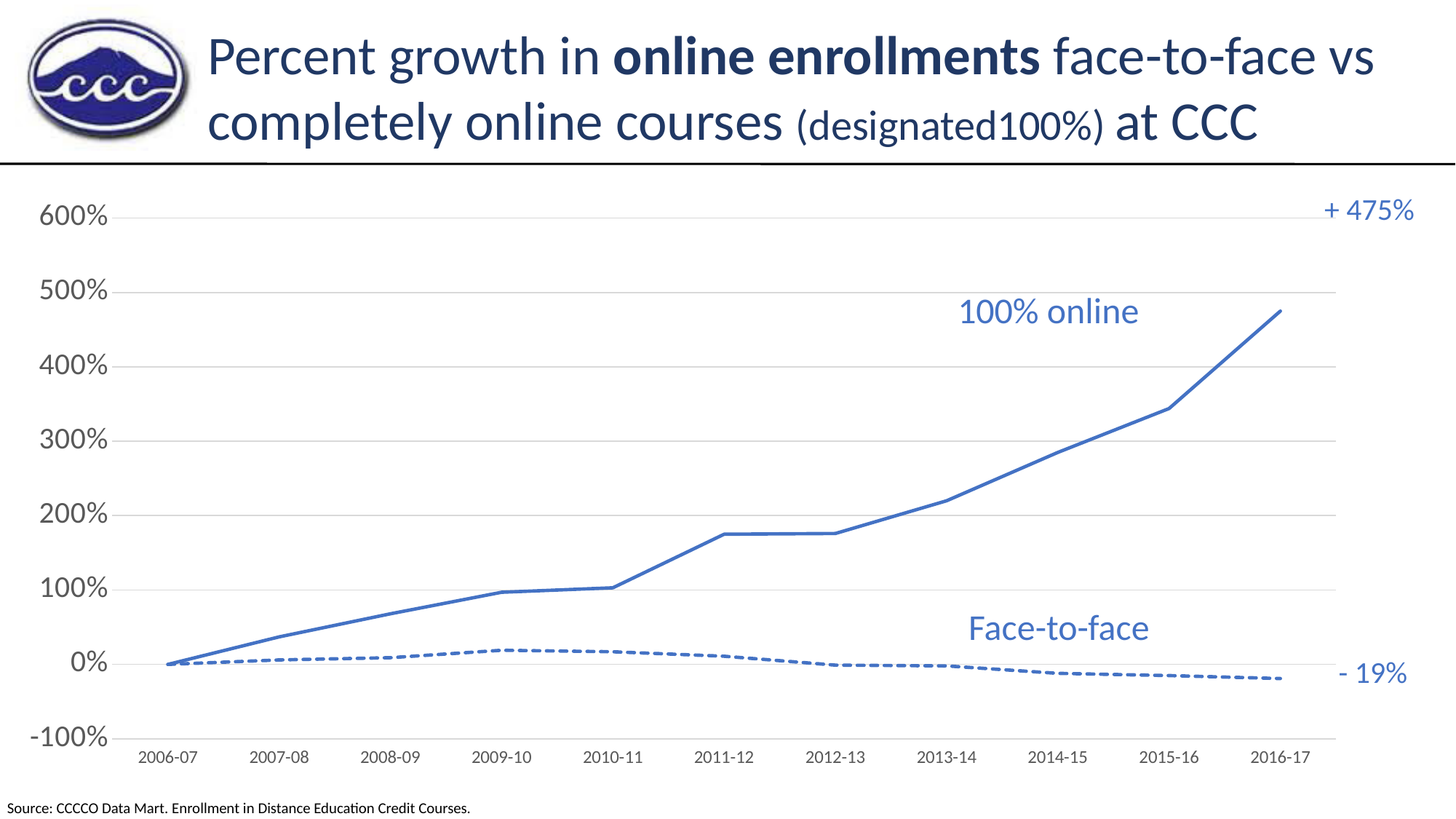
By how many percentage points does the 100% online value exceed the Face-to-face value in 2016-17? 494 percentage points How many data series are plotted on the chart? 2 Which series is drawn with a dashed line? Face-to-face Does the 100% online series rise or fall from 2006-07 to 2016-17? Rise Is the value for 100% online in 2009-10 greater or less than 200%? less What type of chart is shown on the slide? Line chart Does the Face-to-face series rise or fall from 2009-10 to 2016-17? Fall What is the percent growth for Face-to-face enrollments in 2016-17? - 19% What is the percent growth for 100% online enrollments in 2016-17? + 475% Is the value for 100% online in 2015-16 greater or less than 300%? greater How many academic years are plotted along the x axis? 11 In 2016-17, which series has the higher value, 100% online or Face-to-face? 100% online